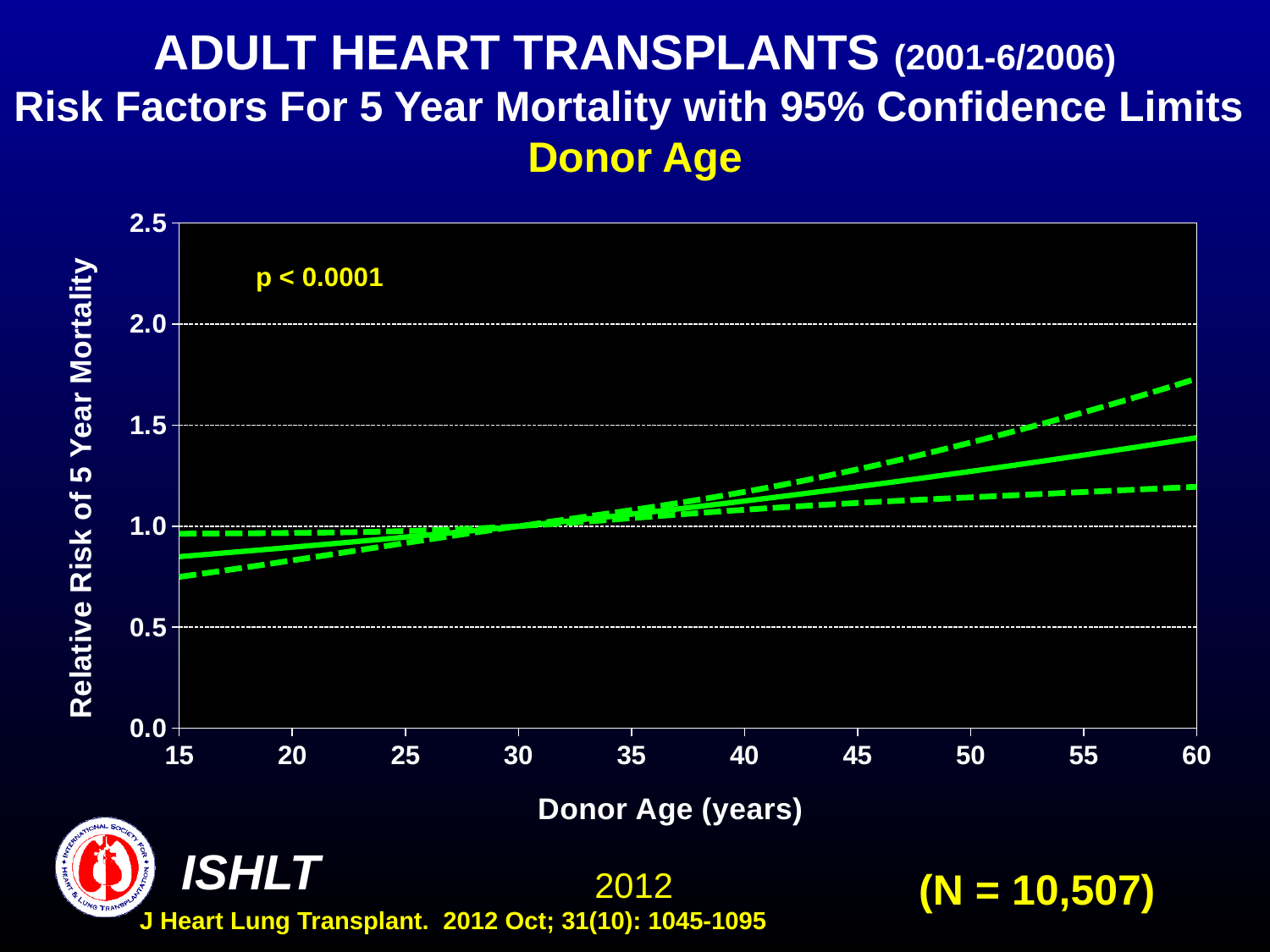
What is the label of the y axis? Relative Risk of 5 Year Mortality What kind of chart is shown on the slide? line chart Is the relative risk of 5 year mortality (solid line) at donor age 60 greater or less than 1.0? greater Is the lower 95% confidence limit at donor age 15 greater or less than 1.0? less Which donor age has the larger relative risk of 5 year mortality on the solid line, 15 years or 60 years? 60 years Does the relative risk of 5 year mortality rise or fall as donor age increases from 15 to 60 years? rise How many lines are plotted on the chart? 3 What p-value is printed on the chart? p < 0.0001 Is the relative risk of 5 year mortality (solid line) at donor age 15 greater or less than 1.0? less How many tick labels are shown on the x axis (Donor Age)? 10